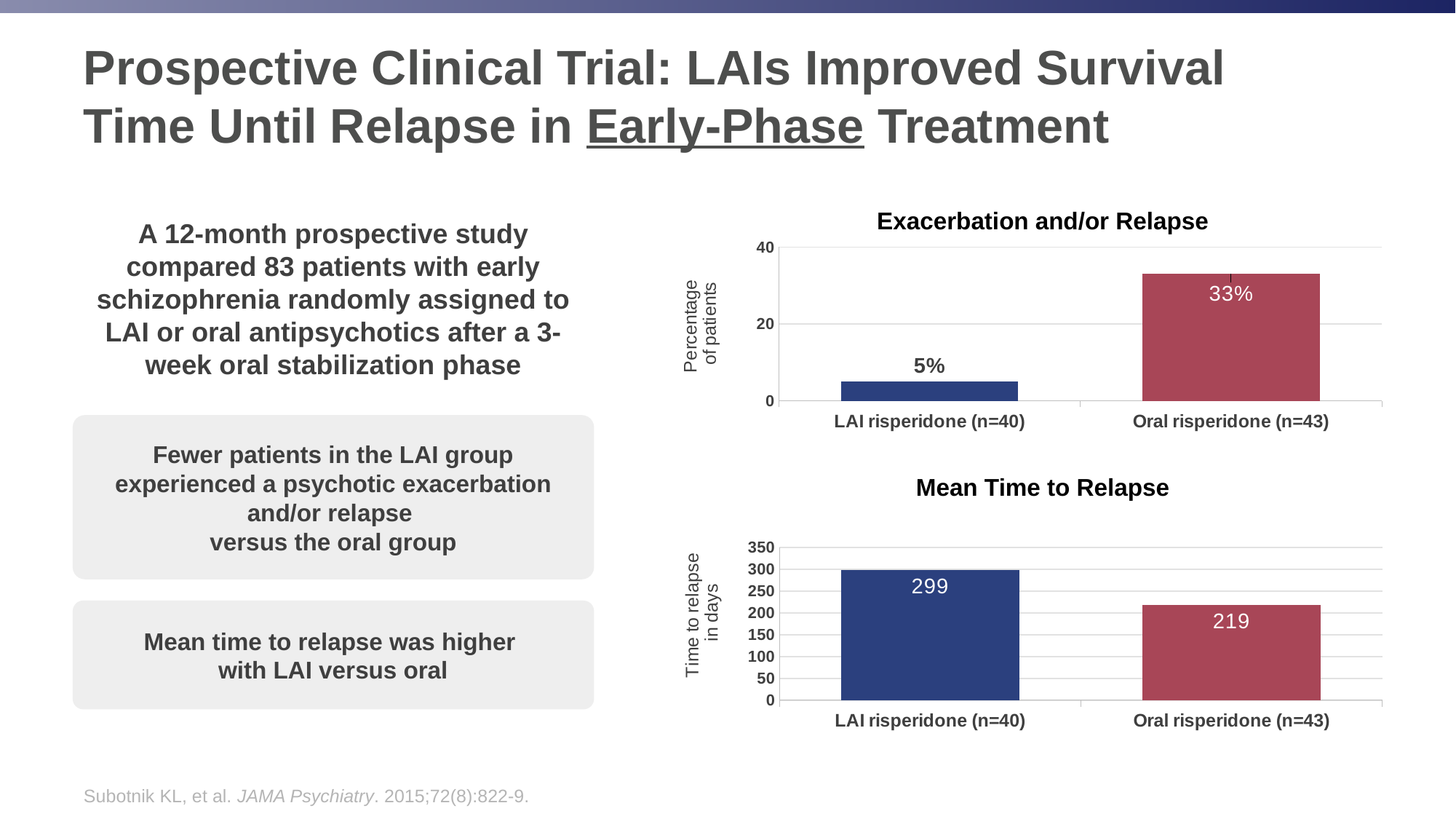
In the 'Exacerbation and/or Relapse' chart, what is the difference in percentage points between Oral risperidone and LAI risperidone? 28 In the 'Exacerbation and/or Relapse' chart, what is the value for LAI risperidone (n=40)? 5% In the 'Mean Time to Relapse' chart, is the value for LAI risperidone (n=40) greater or less than 250? greater In the 'Mean Time to Relapse' chart, how many days longer is the mean time to relapse for LAI risperidone than for Oral risperidone? 80 How many categories are shown in the 'Exacerbation and/or Relapse' chart? 2 In the 'Exacerbation and/or Relapse' chart, is the value for Oral risperidone (n=43) greater or less than 20? greater In the 'Mean Time to Relapse' chart, which group has the lower mean time to relapse? Oral risperidone (n=43) In the 'Mean Time to Relapse' chart, what is the value for LAI risperidone (n=40)? 299 In the 'Exacerbation and/or Relapse' chart, what is the value for Oral risperidone (n=43)? 33% In the 'Mean Time to Relapse' chart, what is the value for Oral risperidone (n=43)? 219 What kind of chart is the 'Mean Time to Relapse' chart? Bar chart In the 'Exacerbation and/or Relapse' chart, which group has the higher percentage of patients? Oral risperidone (n=43)